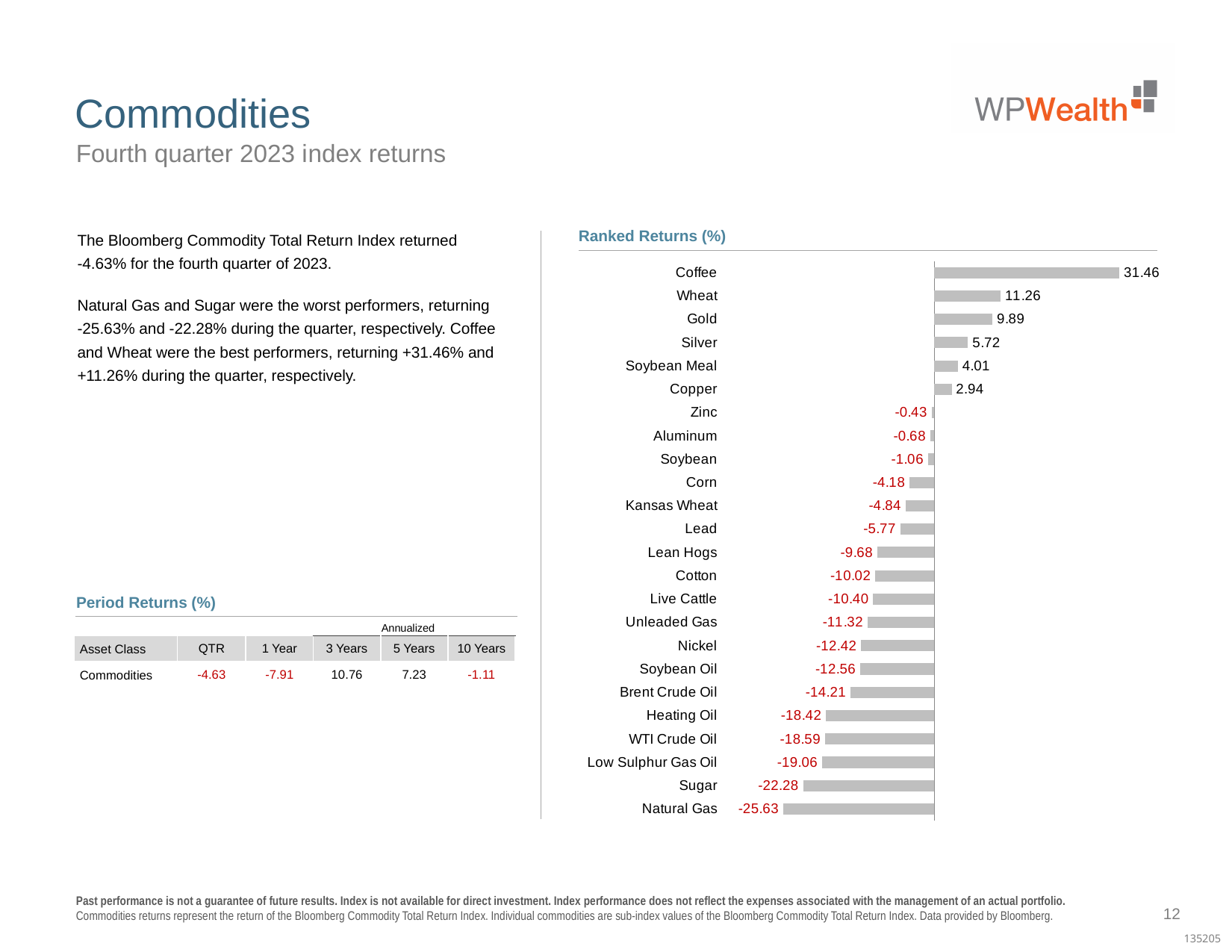
In the Ranked Returns (%) chart, which has the lower return, Sugar or Heating Oil? Sugar In the Ranked Returns (%) chart, which has the higher return, Copper or Zinc? Copper In the Ranked Returns (%) chart, what is the value for Brent Crude Oil? -14.21 In the Ranked Returns (%) chart, which commodity has the lowest return? Natural Gas In the Ranked Returns (%) chart, which commodity has the highest return? Coffee In the Ranked Returns (%) chart, what is the value for Soybean Meal? 4.01 In the Ranked Returns (%) chart, what is the value for Natural Gas? -25.63 What type of chart is the Ranked Returns (%) chart? Bar chart In the Ranked Returns (%) chart, what is the difference between the values for Gold and Silver? 4.17 In the Ranked Returns (%) chart, what is the difference between the values for Coffee and Wheat? 20.20 In the Ranked Returns (%) chart, what is the value for Coffee? 31.46 How many commodities are shown in the Ranked Returns (%) chart? 24